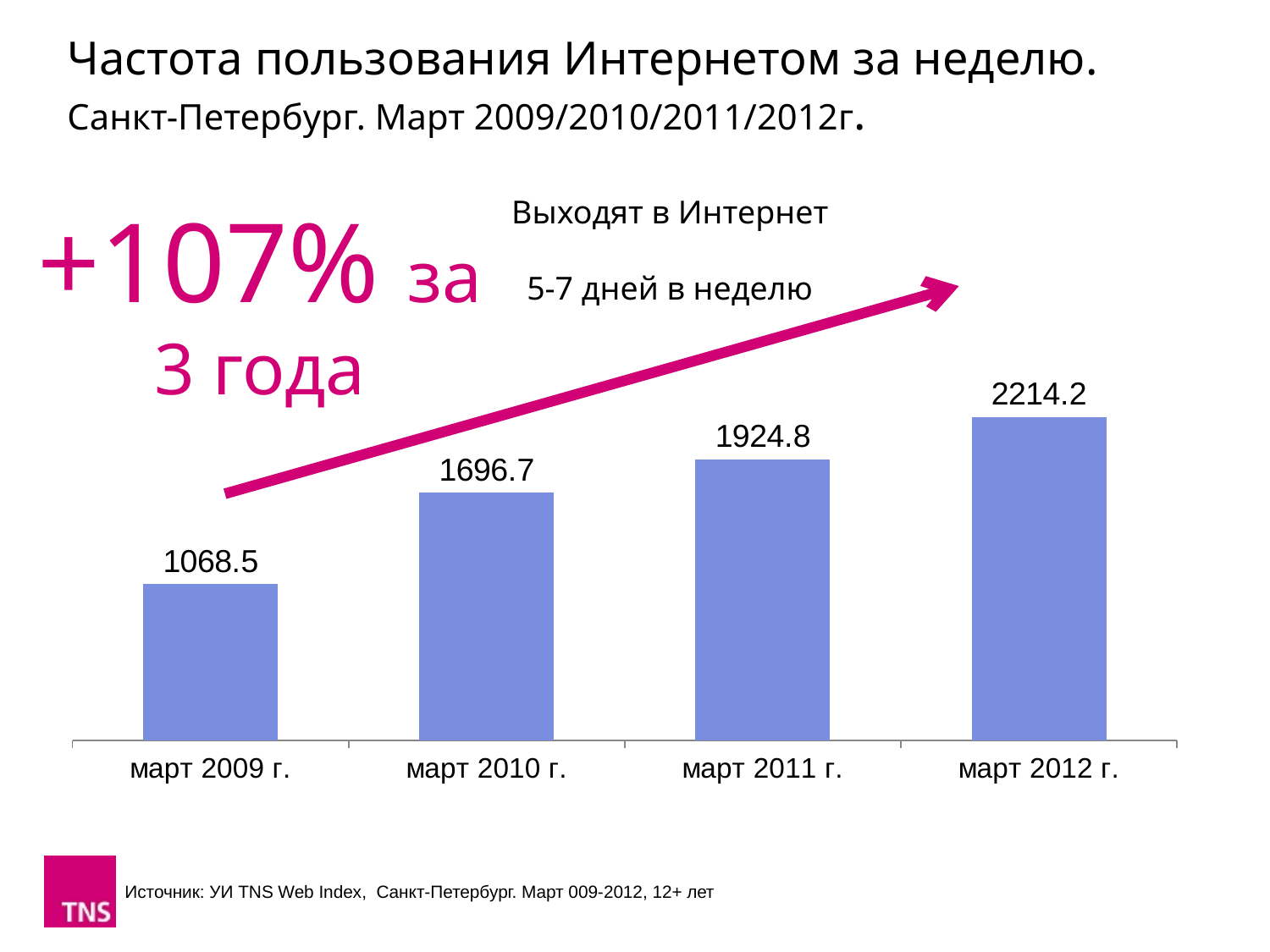
What is the value for март 2011 г.? 1924.8 Which category has the lowest value? март 2009 г. What is the difference between the values for март 2012 г. and март 2009 г.? 1145.7 What kind of chart is this? bar chart Do the values rise or fall from март 2009 г. to март 2012 г.? rise Which category has the highest value? март 2012 г. How many categories are shown on the x axis? 4 What is the value for март 2010 г.? 1696.7 What is the difference between the values for март 2011 г. and март 2010 г.? 228.1 What is the value for март 2012 г.? 2214.2 Which is larger, the value for март 2010 г. or март 2011 г.? март 2011 г. What is the value for март 2009 г.? 1068.5